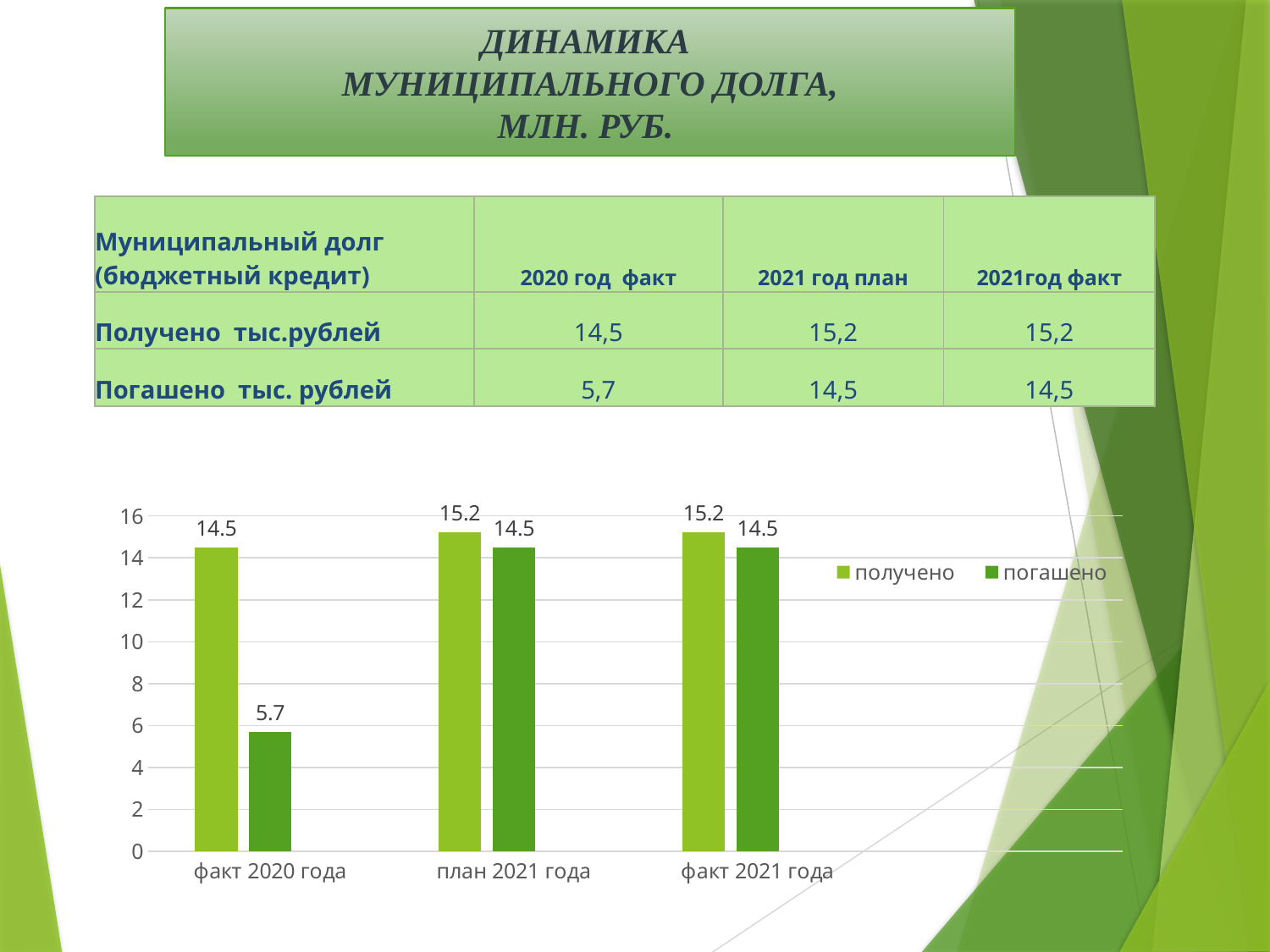
How many categories are shown on the x axis? 3 Which category has the lowest погашено value? факт 2020 года How many series does the legend list? 2 What is the value of погашено for факт 2020 года? 5.7 What is the value of погашено for факт 2021 года? 14.5 What kind of chart is shown on the slide? bar chart What is the difference between получено and погашено for факт 2020 года? 8.8 What is the value of получено for факт 2020 года? 14.5 Does the погашено value rise or fall from факт 2020 года to план 2021 года? rise What is the value of получено for план 2021 года? 15.2 What is the difference between получено and погашено for план 2021 года? 0.7 Which is larger for факт 2021 года: получено or погашено? получено